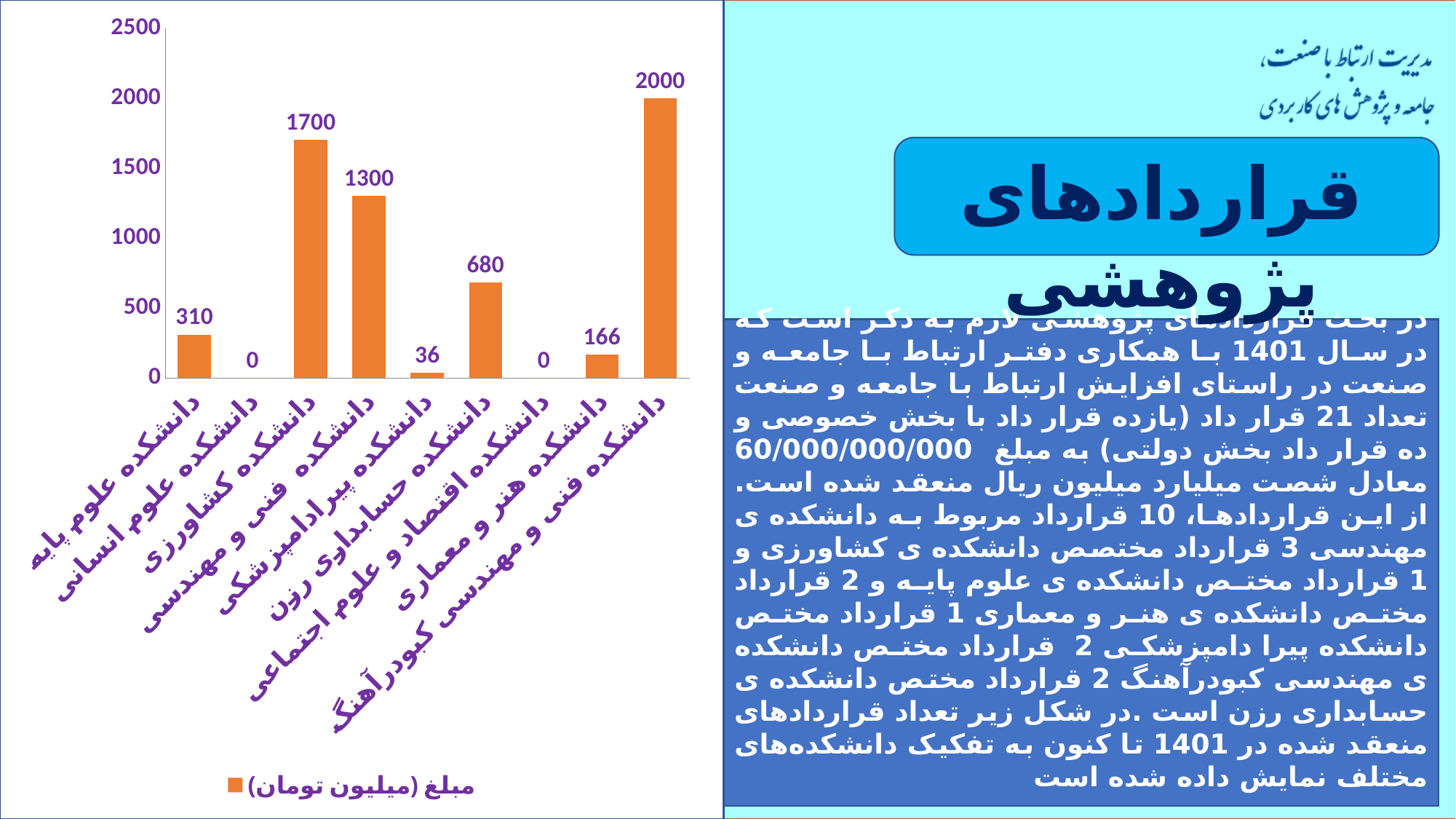
What is the value for دانشکده حسابداری رزن? 680 What kind of chart is shown? bar chart What is the value for دانشکده هنر و معماری? 166 What is the legend entry for the series? مبلغ (میلیون تومان) How many categories have a value of 0? 2 What is the difference between the values for دانشکده کشاورزی and دانشکده فنی و مهندسی? 400 How many categories are shown on the x axis? 9 Which is larger, the value for دانشکده علوم پایه or the value for دانشکده هنر و معماری? دانشکده علوم پایه What is the value for دانشکده کشاورزی? 1700 What is the value for دانشکده پیرادامپزشکی? 36 How many series does the legend list? 1 Which category has the highest value? دانشکده فنی و مهندسی کبودرآهنگ